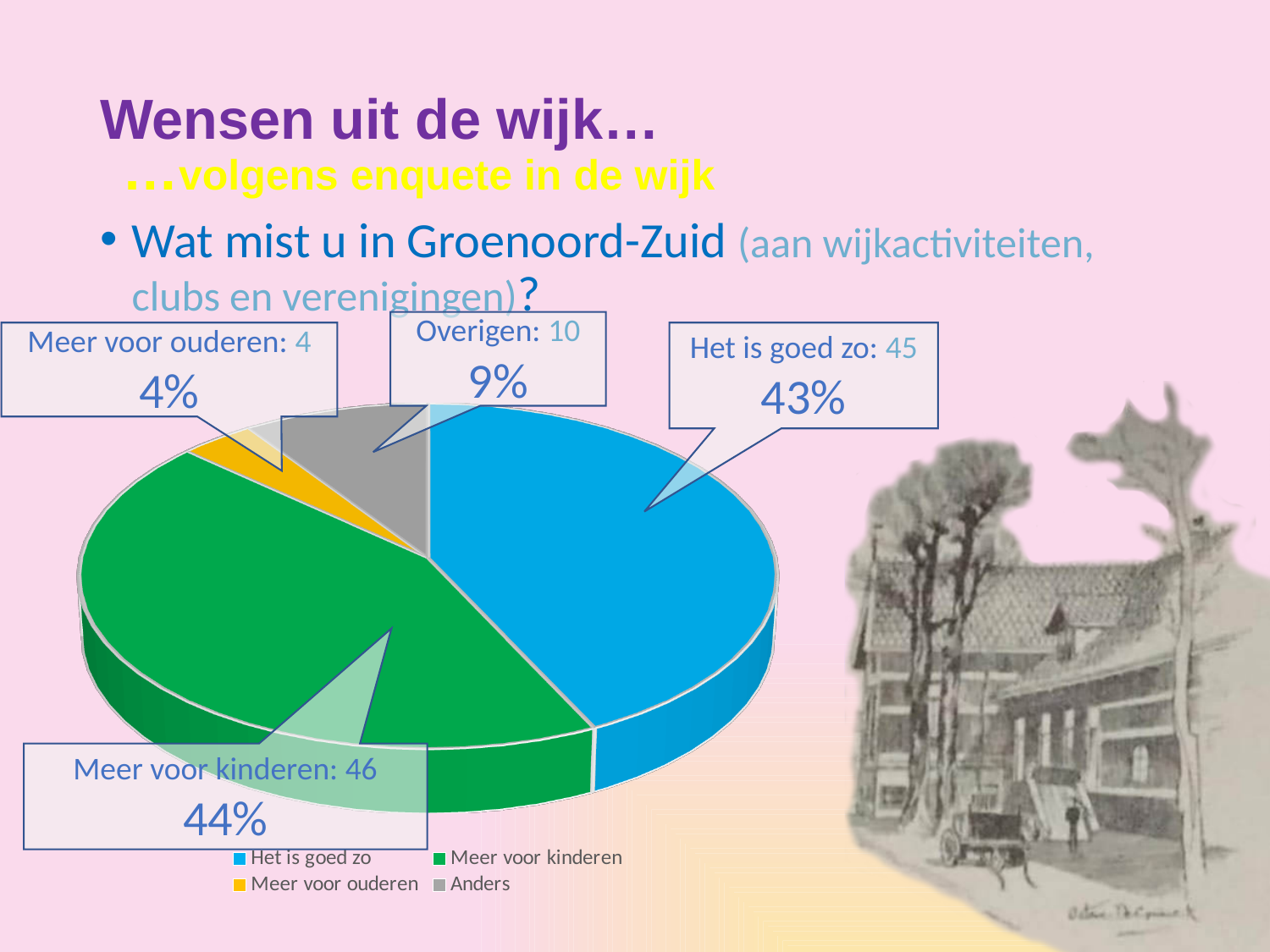
What percentage is shown for the 'Meer voor kinderen' slice of the pie chart? 44% Which category has the largest slice in the pie chart? Meer voor kinderen What percentage is shown for the 'Overigen' slice of the pie chart? 9% Which category has the smallest slice in the pie chart? Meer voor ouderen What is the count shown for 'Het is goed zo' in the pie chart? 45 What is the count shown for 'Meer voor kinderen' in the pie chart? 46 How many slices does the pie chart have? 4 Which colour represents 'Meer voor ouderen' in the pie chart legend? orange/yellow What is the difference between the counts for 'Het is goed zo' and 'Overigen' in the pie chart? 35 What is the count shown for 'Meer voor ouderen' in the pie chart? 4 How many entries does the legend of the pie chart list? 4 What kind of chart is shown on the slide? pie chart